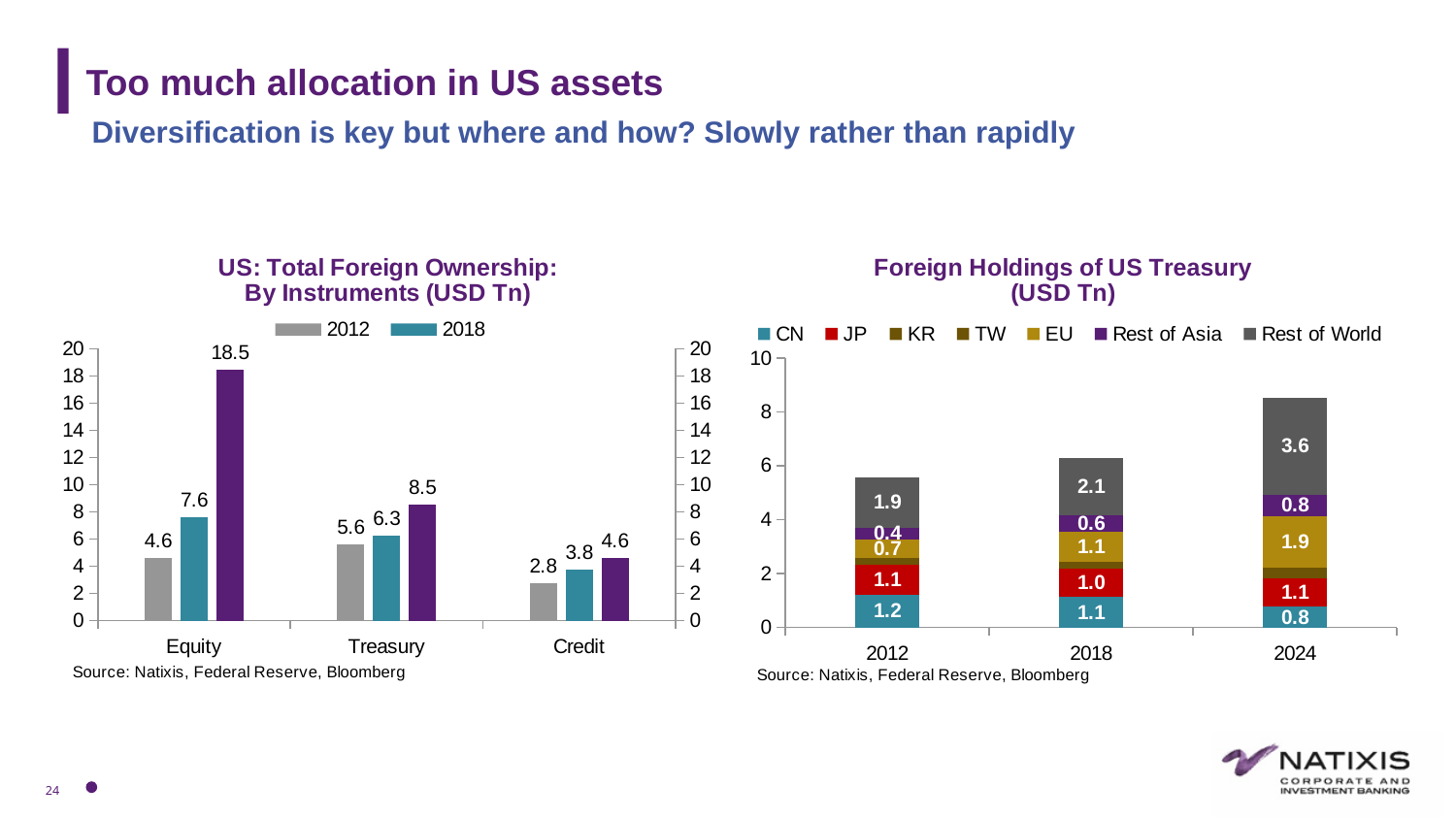
In the 'US: Total Foreign Ownership: By Instruments' chart, what is the 2012 value for Credit? 2.8 In the 'Foreign Holdings of US Treasury' chart, how many series does the legend list? 7 In the 'Foreign Holdings of US Treasury' chart, is the total height of the 2024 bar greater or less than 8? greater In the 'US: Total Foreign Ownership: By Instruments' chart, how many series does the legend list? 2 In the 'Foreign Holdings of US Treasury' chart, what is the value for Rest of World in 2018? 2.1 In the 'US: Total Foreign Ownership: By Instruments' chart, what is the 2012 value for Treasury? 5.6 In the 'US: Total Foreign Ownership: By Instruments' chart, which instrument has the highest 2018 value? Equity In the 'US: Total Foreign Ownership: By Instruments' chart, what is the difference between the 2018 and 2012 values for Equity? 3.0 In the 'Foreign Holdings of US Treasury' chart, is the EU value larger in 2012 or in 2024? 2024 In the 'Foreign Holdings of US Treasury' chart, what is the value for CN in 2024? 0.8 What kind of chart is the 'US: Total Foreign Ownership: By Instruments' chart? Bar chart In the 'US: Total Foreign Ownership: By Instruments' chart, what is the 2018 value for Equity? 7.6